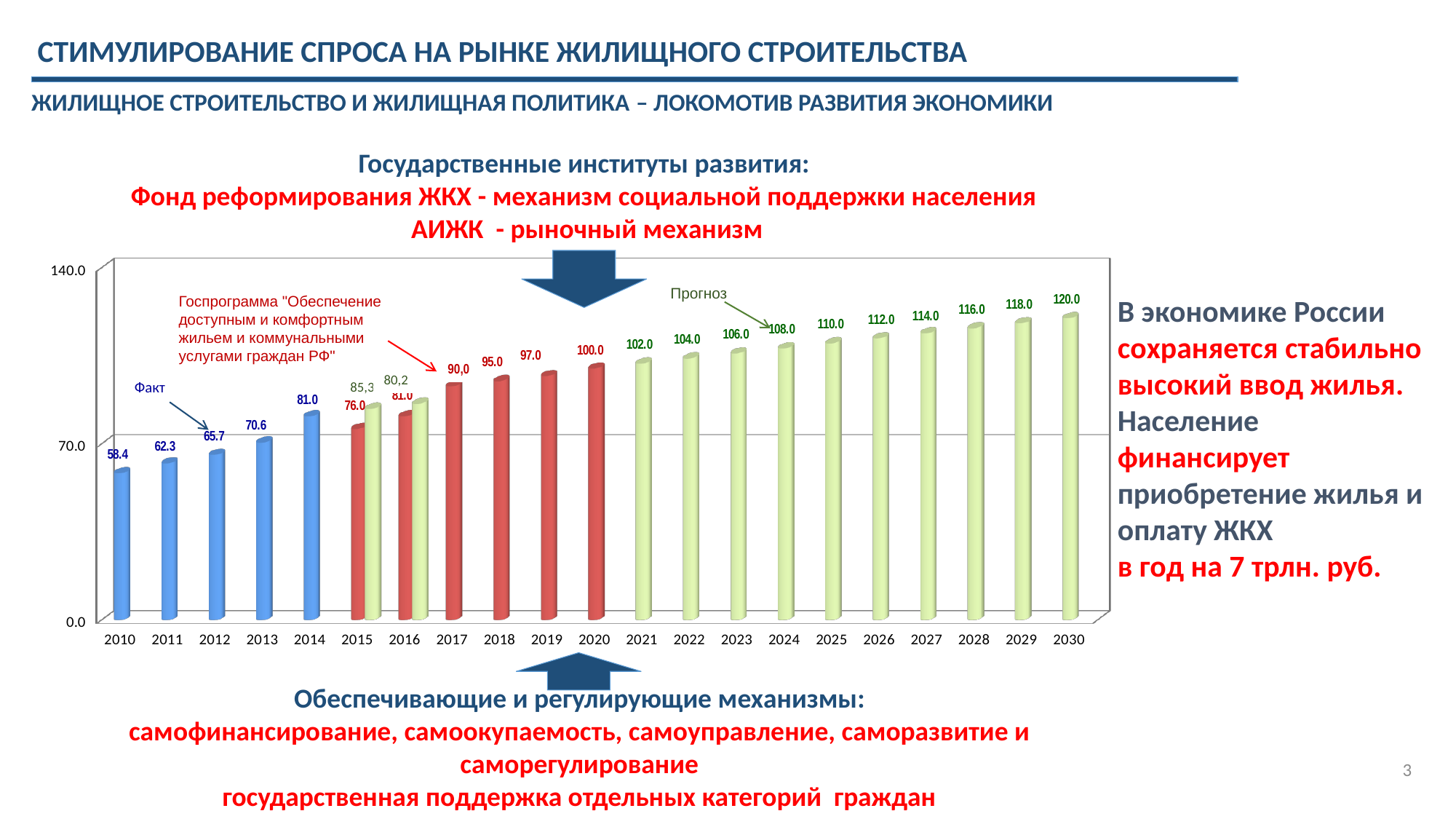
Which year has the highest value on the chart? 2030 Which year has the lowest value on the chart? 2010 What is the difference between the values for 2014 and 2013? 10.4 What is the value shown for 2030? 120.0 Which is larger, the value for 2012 or the value for 2013? 2013 What is the value shown for 2020? 100.0 How many years are shown on the x axis of the chart? 21 Is the value for 2010 greater or less than 70.0? less What is the difference between the values for 2030 and 2021? 18.0 What is the value shown for 2014? 81.0 What is the value shown for 2010? 58.4 What kind of chart is shown on the slide? bar chart